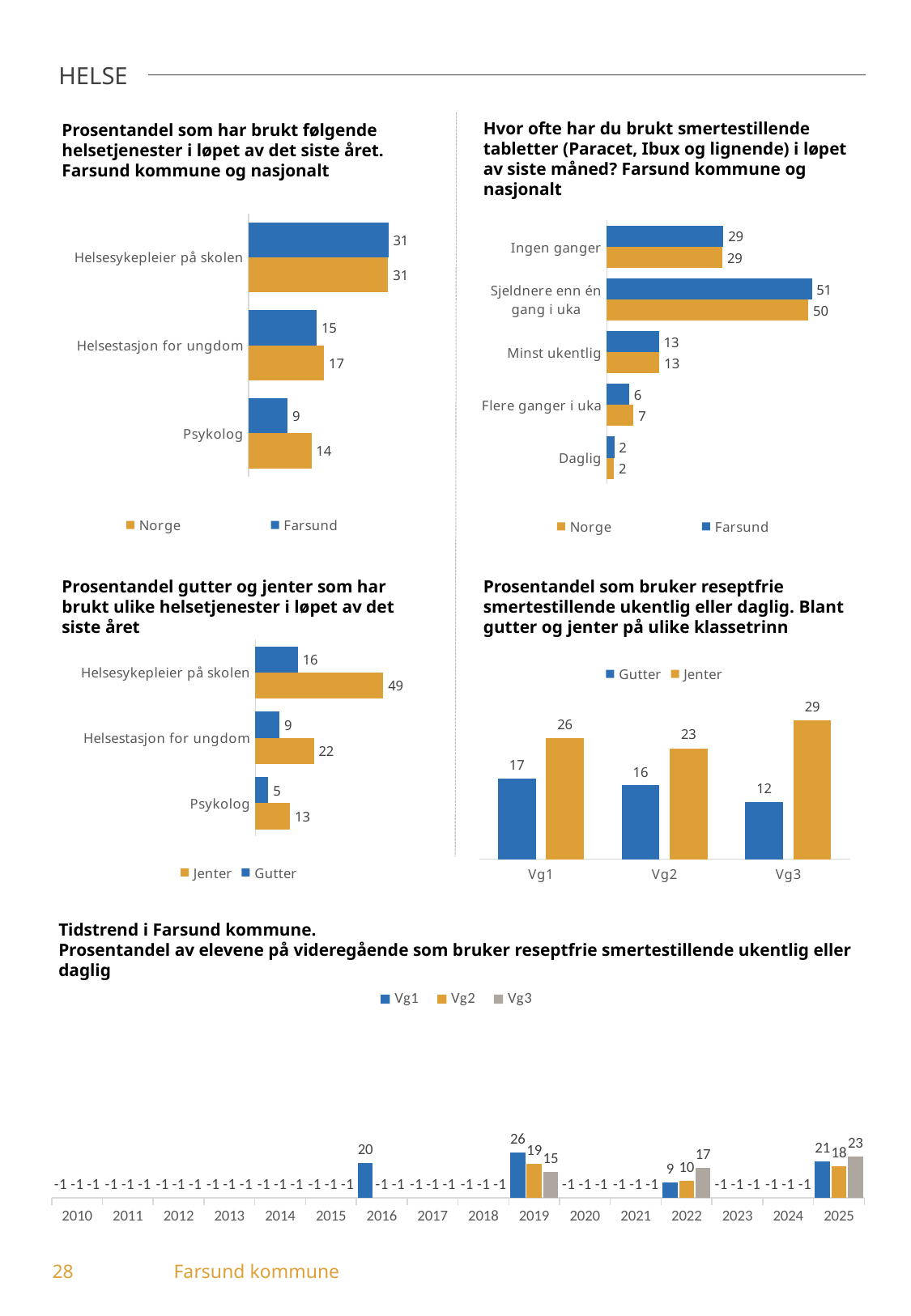
In the chart 'Tidstrend i Farsund kommune', what is the difference between the Vg3 values in 2025 and 2022? 6 In the chart 'Prosentandel som har brukt følgende helsetjenester i løpet av det siste året', what is the difference between the Norge and Farsund values for Helsestasjon for ungdom? 2 In the chart 'Prosentandel gutter og jenter som har brukt ulike helsetjenester', what is the value for Jenter for Helsesykepleier på skolen? 49 In the chart 'Prosentandel som har brukt følgende helsetjenester i løpet av det siste året', what is the value for Farsund for Psykolog? 9 In the chart 'Prosentandel gutter og jenter som har brukt ulike helsetjenester', which is larger for Helsestasjon for ungdom: Gutter or Jenter? Jenter In the chart 'Hvor ofte har du brukt smertestillende tabletter', which category has the highest value for Farsund? Sjeldnere enn én gang i uka In the chart 'Hvor ofte har du brukt smertestillende tabletter', what is the Norge value for Flere ganger i uka? 7 In the chart 'Tidstrend i Farsund kommune', what is the value for Vg1 in 2019? 26 How many categories are shown in the chart 'Hvor ofte har du brukt smertestillende tabletter'? 5 How many series does the legend list in the chart 'Tidstrend i Farsund kommune'? 3 In the chart 'Prosentandel som bruker reseptfrie smertestillende ukentlig eller daglig', which class level has the highest value for Jenter? Vg3 In the chart 'Prosentandel som bruker reseptfrie smertestillende ukentlig eller daglig', what is the value for Gutter in Vg3? 12